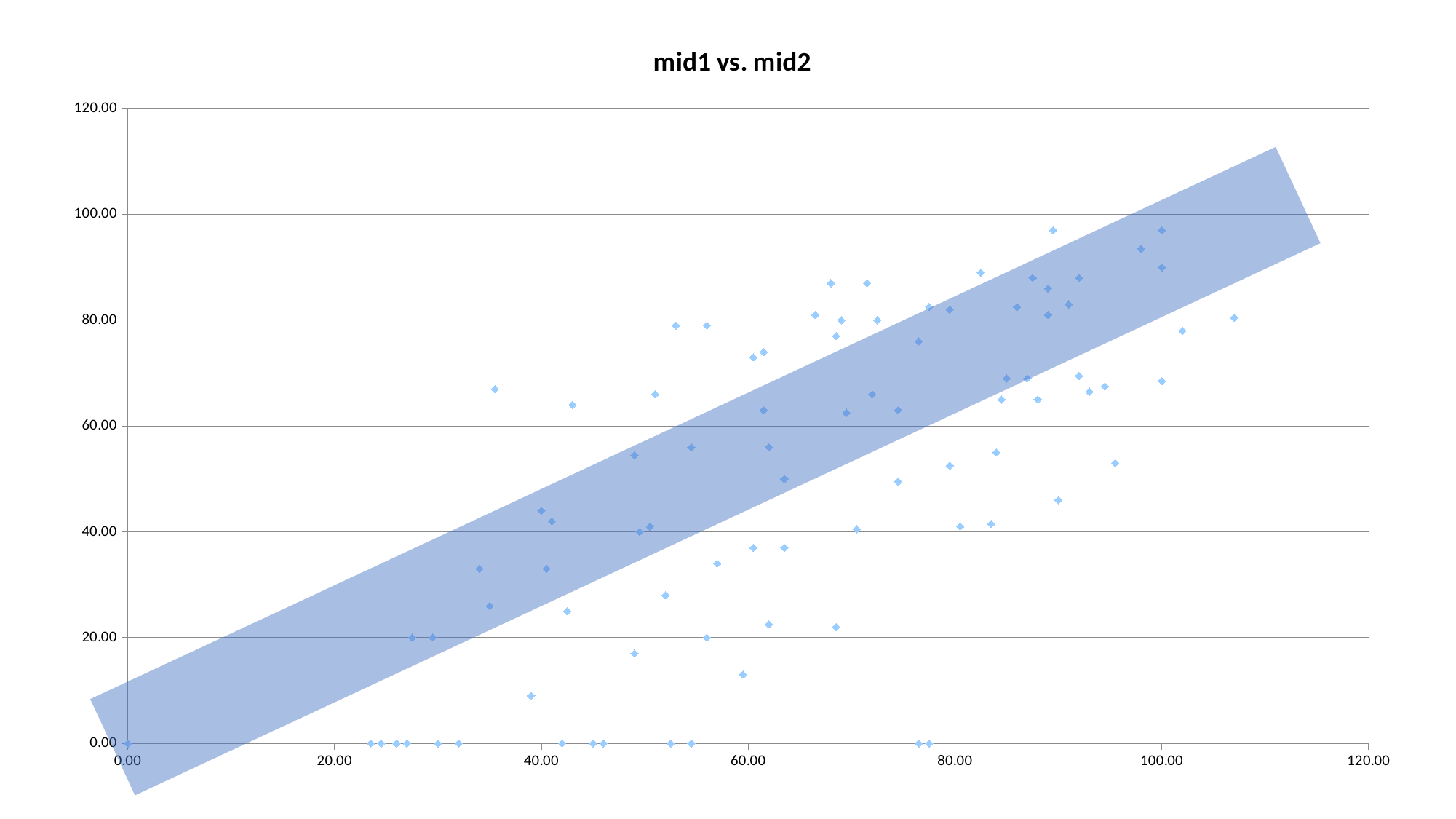
What is the highest value shown on the vertical axis? 120.00 Is the highest plotted point on the chart greater or less than 80 on the vertical axis? greater Is the point with the largest x-axis value greater or less than 100 on the horizontal axis? greater What is the title of the chart? mid1 vs. mid2 What kind of chart is shown on the slide? scatter plot Is the lowest plotted point on the chart greater or less than 20 on the vertical axis? less Do the plotted points generally rise or fall as the x-axis value increases? rise